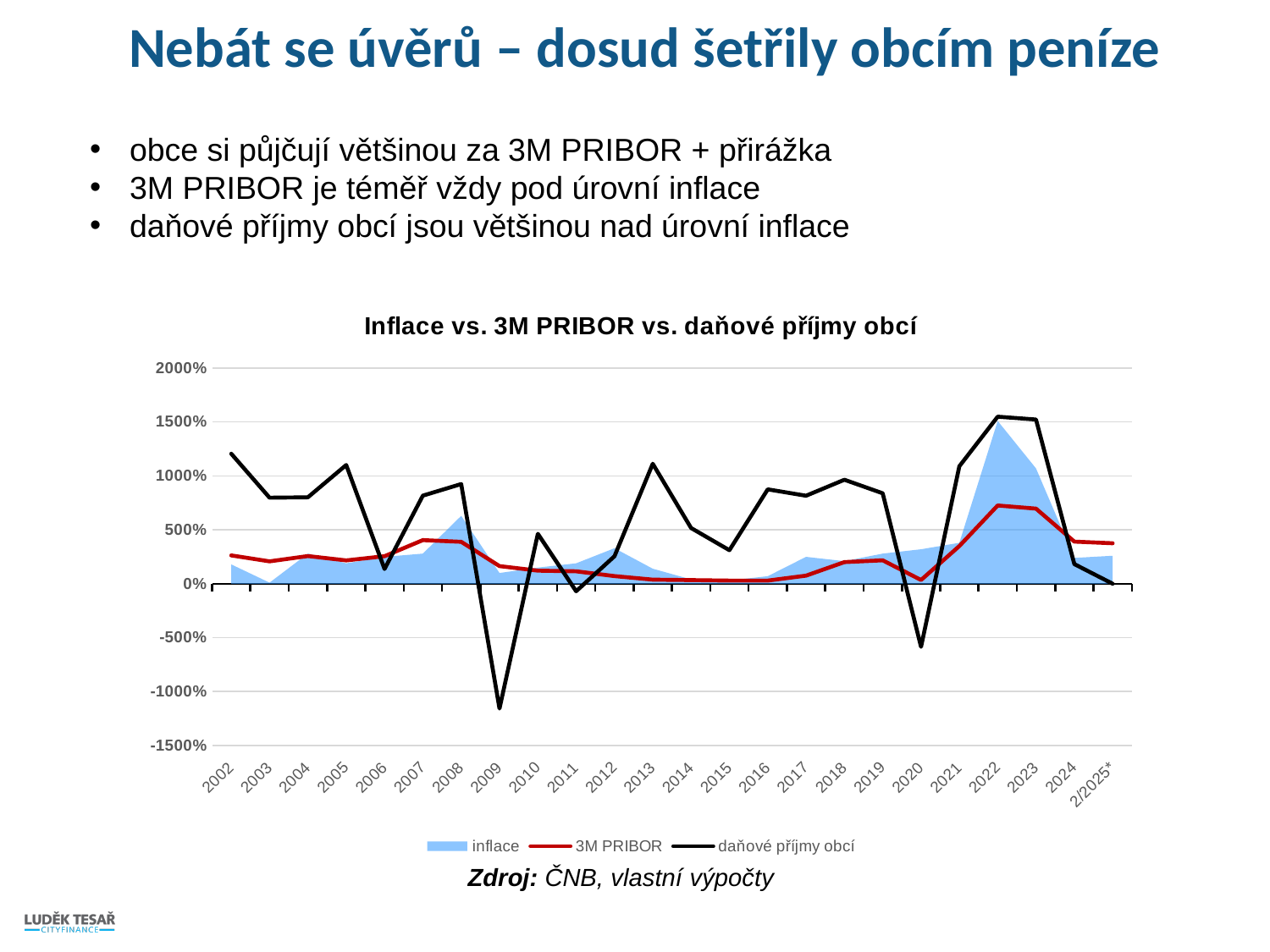
What type of chart is shown on the slide? Line chart with an area series How many years (categories) are shown on the x axis of the chart? 24 In 2022, which is larger: daňové příjmy obcí or 3M PRIBOR? daňové příjmy obcí What is the title of the chart? Inflace vs. 3M PRIBOR vs. daňové příjmy obcí How many series does the chart legend list? 3 Does the daňové příjmy obcí series rise or fall from 2022 to 2/2025*? fall Is the value of 3M PRIBOR in 2022 greater or less than 500%? greater Which series are listed in the chart legend? inflace, 3M PRIBOR, daňové příjmy obcí In which year does the daňové příjmy obcí series reach its lowest value? 2009 Is the value of daňové příjmy obcí in 2009 greater or less than -1000%? less In which year does the daňové příjmy obcí series reach its highest value? 2022 In which year does the inflace series reach its highest value? 2022